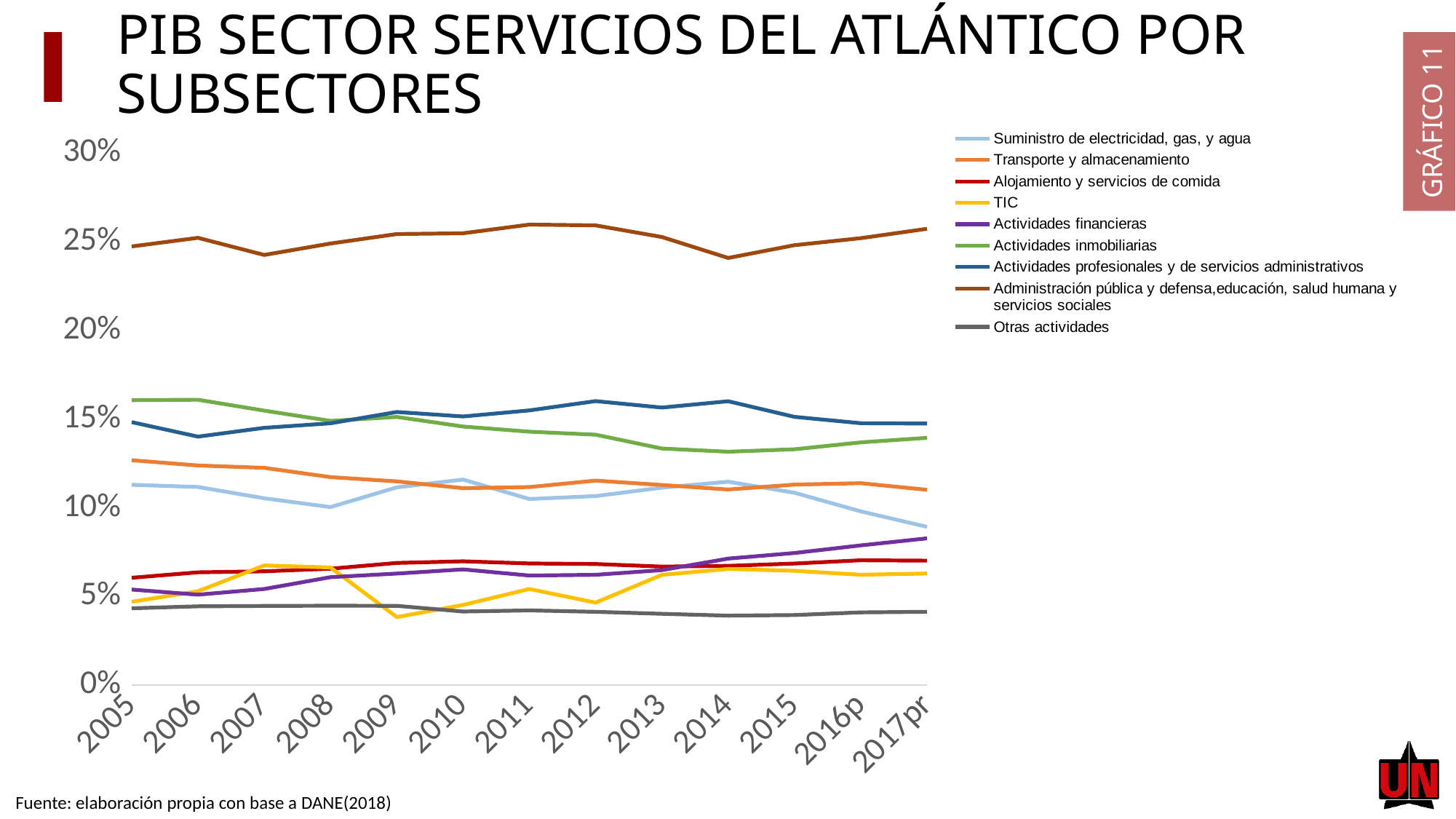
Is the value for Otras actividades in 2017pr greater or less than 5%? less What is the title of the chart? PIB SECTOR SERVICIOS DEL ATLÁNTICO POR SUBSECTORES What kind of chart is shown on the slide? line chart Is the value for Suministro de electricidad, gas, y agua in 2017pr greater or less than 10%? less Which subsector has the lowest share in 2017pr? Otras actividades Does the share of Actividades inmobiliarias rise or fall between 2005 and 2017pr? fall Does the share of Actividades financieras rise or fall between 2005 and 2017pr? rise Which subsector has the highest share across all years shown? Administración pública y defensa, educación, salud humana y servicios sociales In 2005, which is larger: Actividades inmobiliarias or Actividades profesionales y de servicios administrativos? Actividades inmobiliarias Is the value for Administración pública y defensa, educación, salud humana y servicios sociales in 2005 greater or less than 20%? greater How many years are shown along the x axis? 13 How many series does the legend list? 9